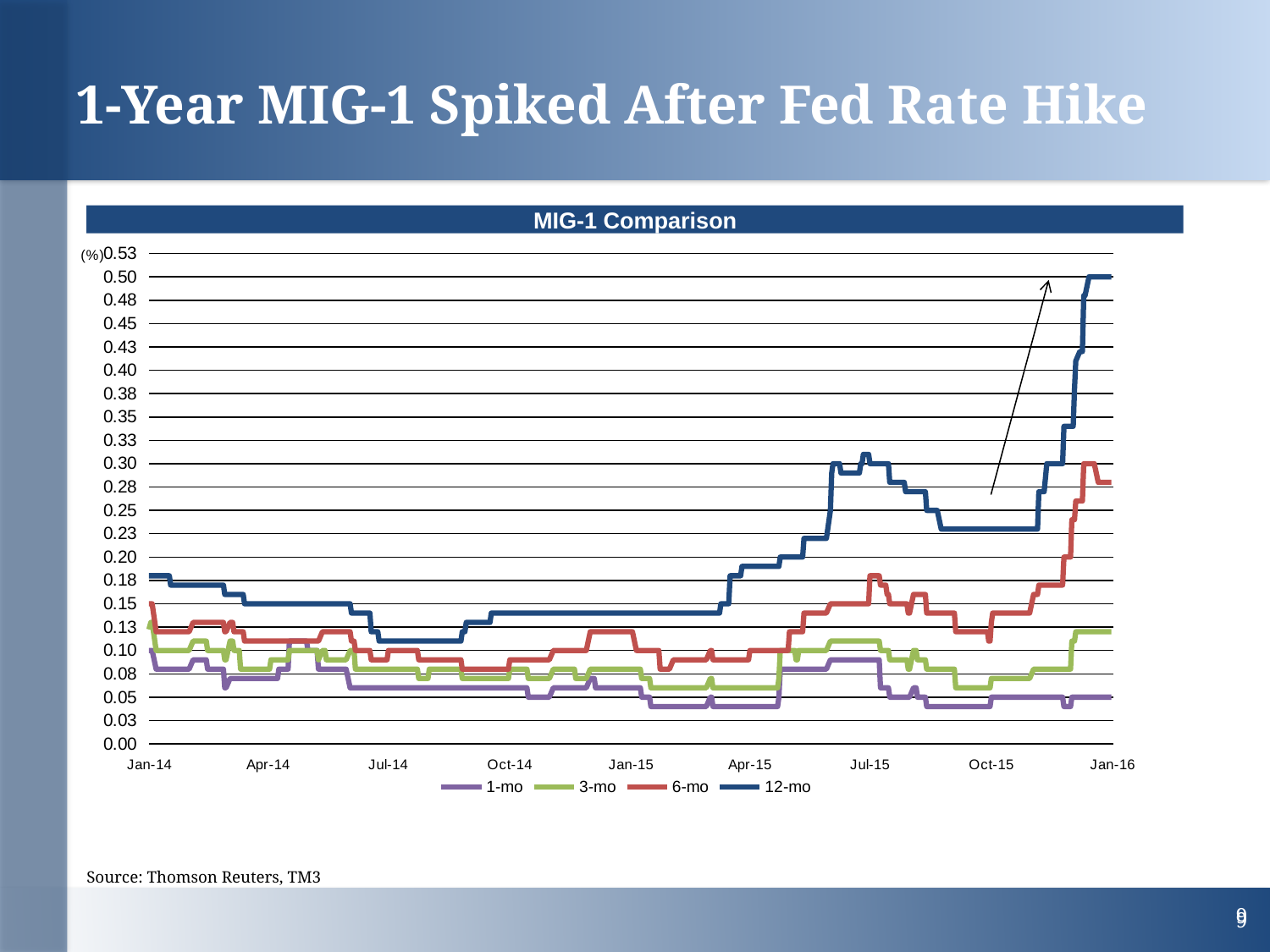
Is the value of the 12-mo series at Jan-16 greater or less than 0.45? greater Is the value of the 6-mo series at Jan-16 greater or less than 0.20? greater Is the value of the 1-mo series at Jan-16 greater or less than 0.10? less What kind of chart is shown on the slide? line chart Which series are listed in the chart's legend? 1-mo, 3-mo, 6-mo, 12-mo Which series has the highest value at Jan-16? 12-mo What is the title of the chart? MIG-1 Comparison Which series has the lowest value at Jan-16? 1-mo At Jan-16, which is larger: the 12-mo series or the 6-mo series? 12-mo How many series does the legend of the MIG-1 Comparison chart list? 4 Does the 12-mo series rise or fall between Oct-15 and Jan-16? rise